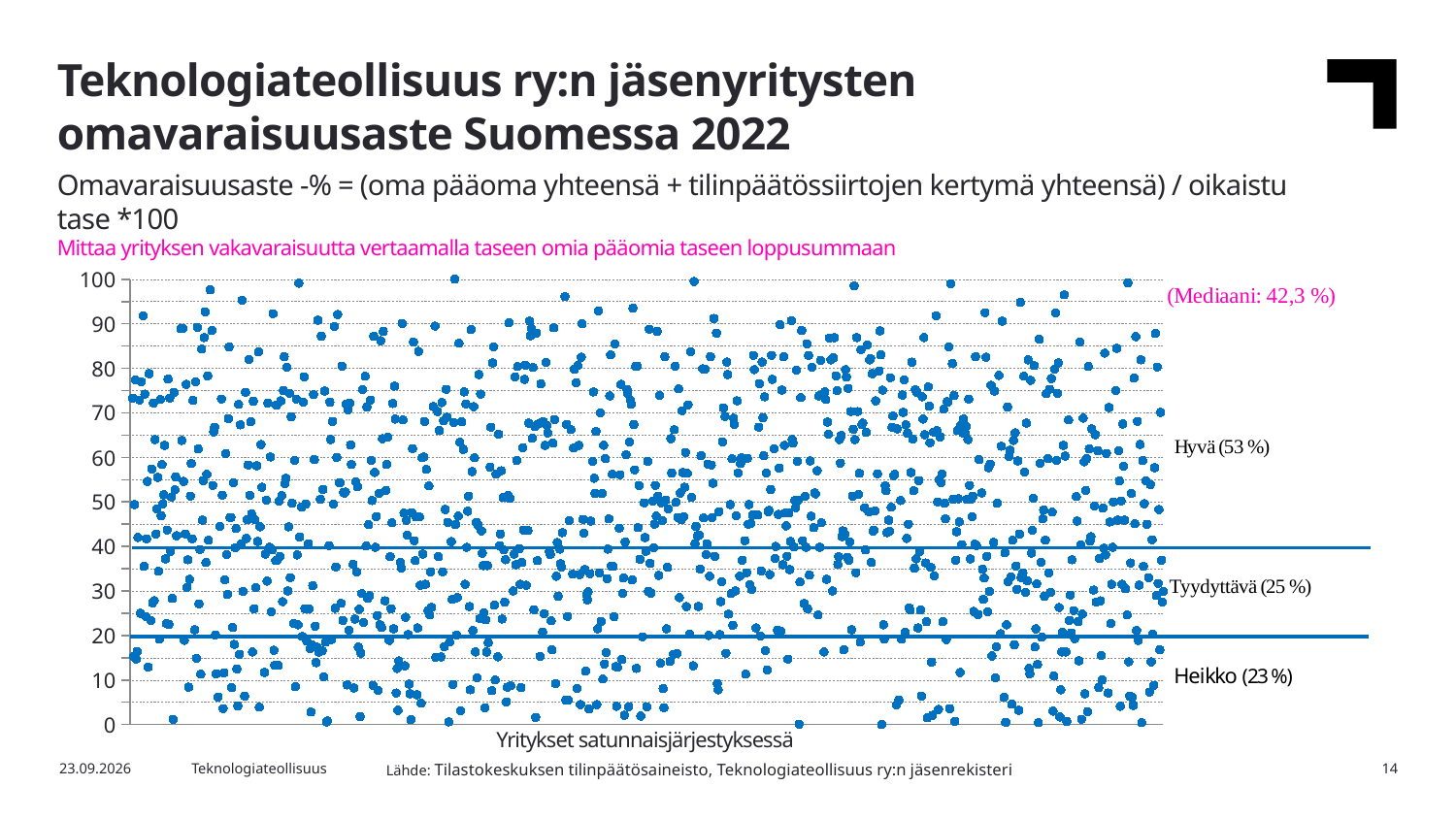
What is the difference in percentage points between the 'Hyvä' share and the 'Heikko' share? 30 What share of companies falls in the 'Heikko' group according to the chart label? 23 % Which of the three labelled groups (Hyvä, Tyydyttävä, Heikko) has the largest share? Hyvä What share of companies falls in the 'Tyydyttävä' group according to the chart label? 25 % What share of companies falls in the 'Hyvä' group according to the chart label? 53 % What is the highest value shown on the y axis of the chart? 100 Which of the three labelled groups (Hyvä, Tyydyttävä, Heikko) has the smallest share? Heikko What median value (Mediaani) is printed on the chart? 42,3 % What kind of chart is shown on the slide? Scatter chart Is the share for 'Hyvä' larger or smaller than the share for 'Heikko'? Larger What is the label of the x axis of the chart? Yritykset satunnaisjärjestyksessä At which two y-axis values are the horizontal threshold lines drawn on the chart? 40 and 20